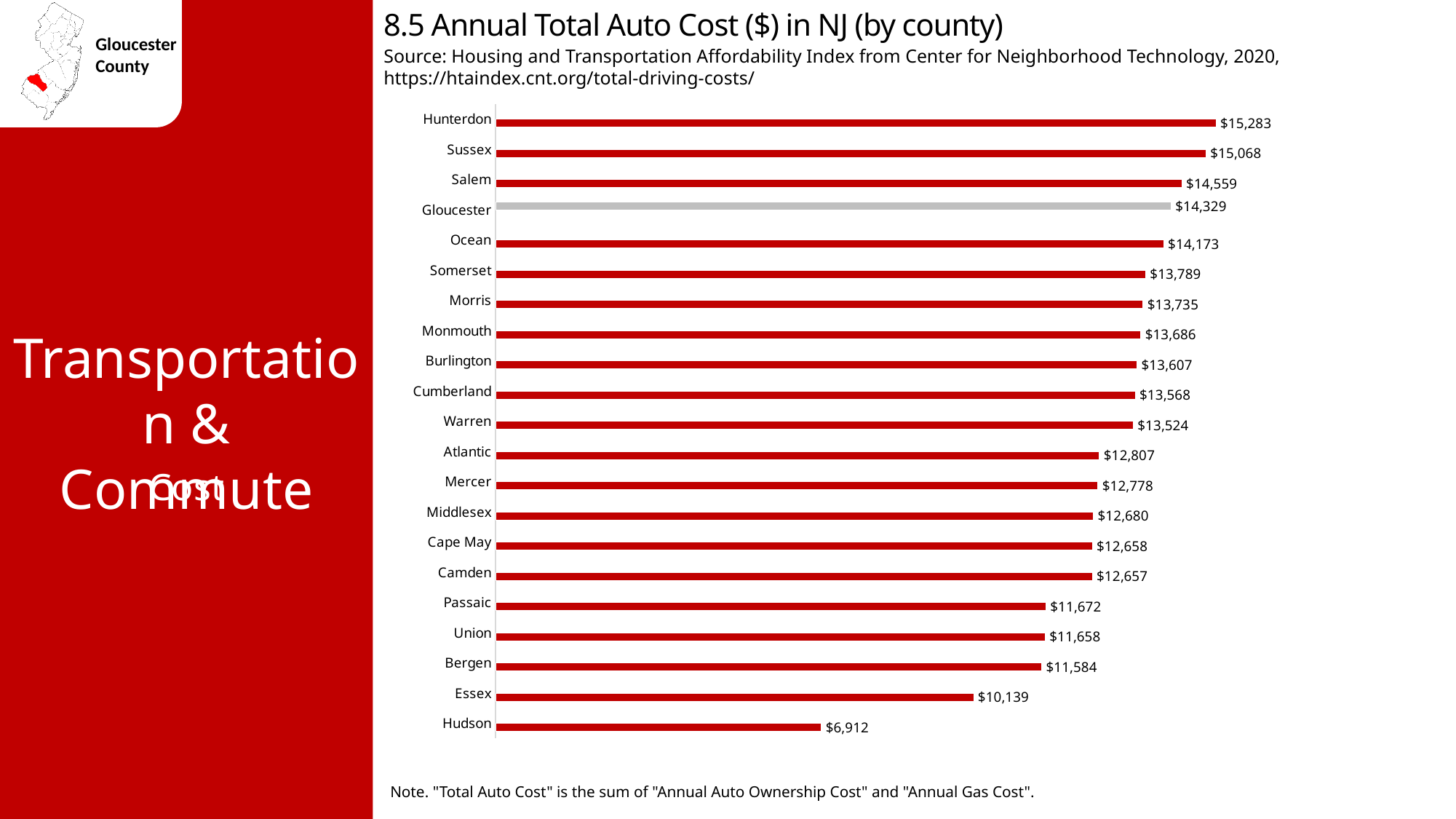
How many counties are shown in the chart? 21 What is the difference in annual total auto cost between Hunterdon and Hudson? $8,371 Which county has the lowest annual total auto cost? Hudson Which county has the highest annual total auto cost? Hunterdon What is the annual total auto cost for Gloucester County? $14,329 Which has a higher annual total auto cost, Sussex or Somerset? Sussex What is the difference in annual total auto cost between Gloucester and Salem? $230 Which has a higher annual total auto cost, Essex or Bergen? Bergen What is the annual total auto cost for Hudson County? $6,912 Which county's bar is shown in gray rather than red? Gloucester What is the annual total auto cost for Ocean County? $14,173 What type of chart is shown on the slide? Bar chart